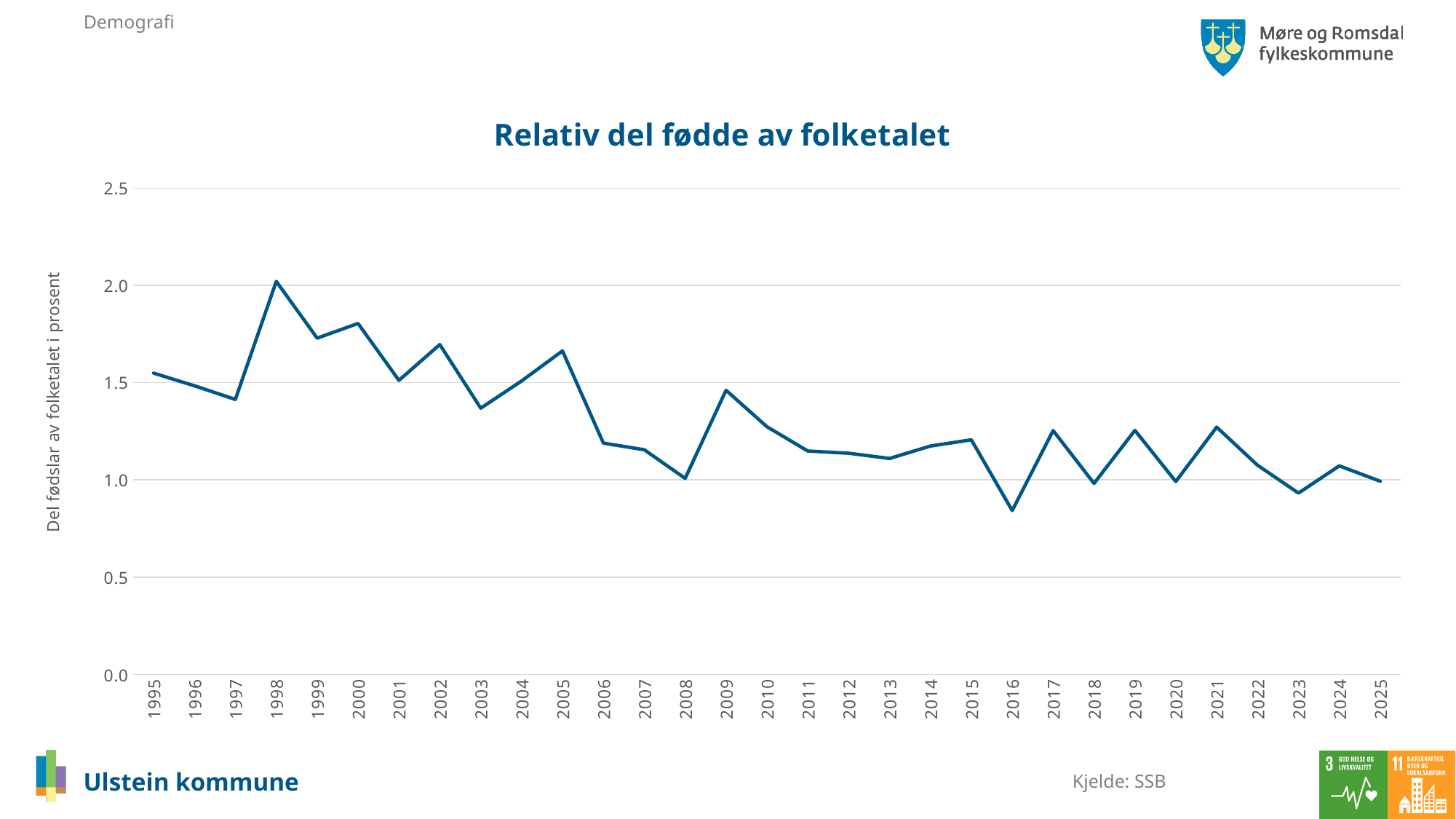
How many years are plotted along the x axis? 31 Is the value for 2003 greater or less than 1.5? less What is the title of the chart? Relativ del fødde av folketalet Is the value for 1998 greater or less than 1.5? greater What kind of chart is shown on the slide? line chart What is the label on the vertical axis of the chart? Del fødslar av folketalet i prosent Overall, do the values rise or fall from 1995 to 2025? fall Which year has the highest value in the chart? 1998 Which year has the lowest value in the chart? 2016 Which year has the larger value, 2005 or 2006? 2005 Which year has the larger value, 1995 or 2025? 1995 Is the value for 2016 greater or less than 1.0? less